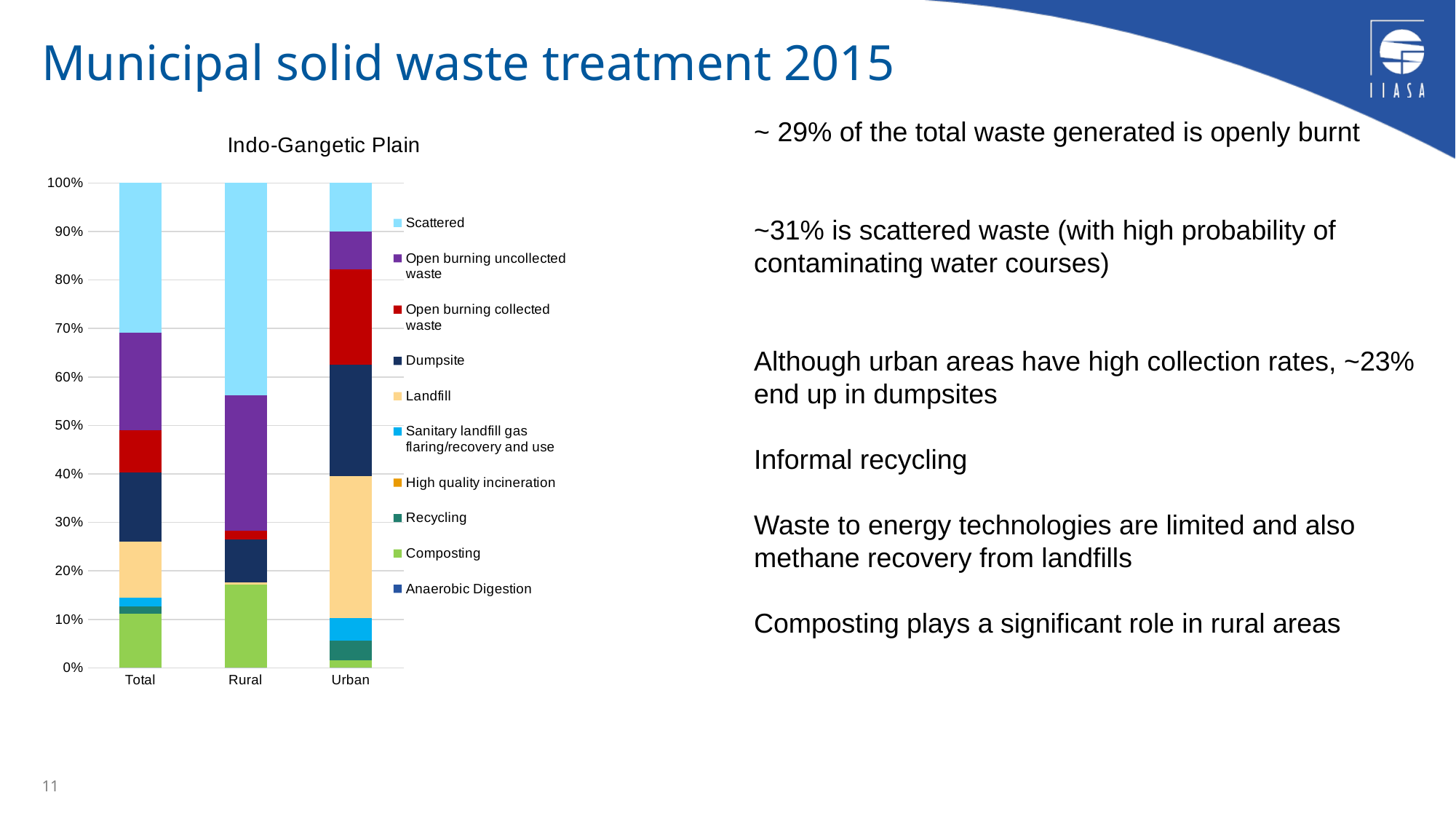
Is the Scattered share for Rural greater or less than 40%? greater Which has the larger Open burning uncollected waste share, Rural or Urban? Rural Which category has the largest Landfill share? Urban How many series does the chart legend list? 10 What is the title of the chart? Indo-Gangetic Plain Is the Composting share for Urban greater or less than 10%? less What does each stacked bar in the chart total? 100% How many categories are shown on the x axis of the chart? 3 What type of chart is shown on the slide? Stacked bar chart Is the Composting share for Rural greater or less than 10%? greater Which has the larger Open burning collected waste share, Rural or Urban? Urban